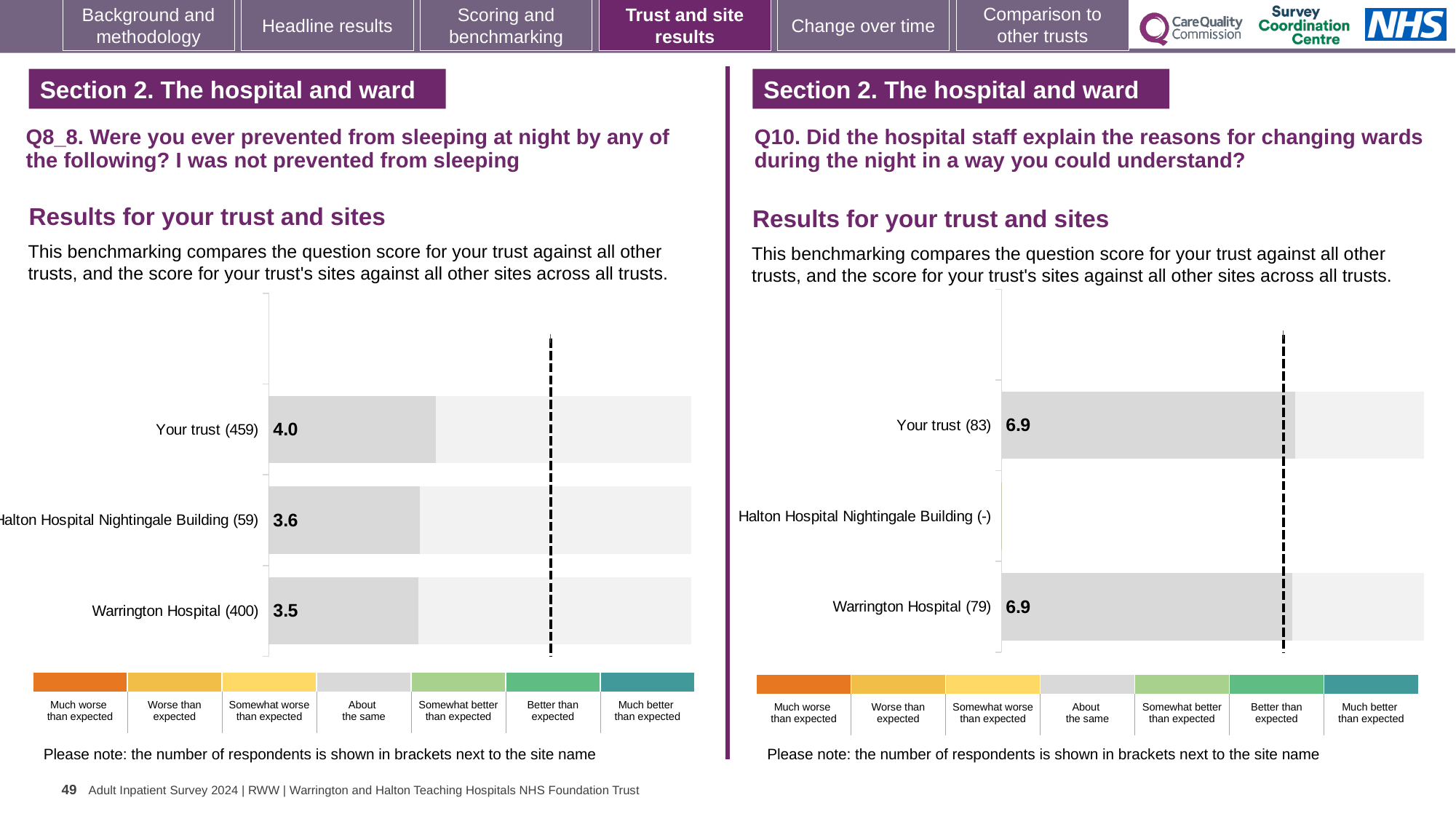
On the Q8_8 chart (left), what is the score for Halton Hospital Nightingale Building? 3.6 On the Q8_8 chart (left), what is the score for Your trust? 4.0 On the Q8_8 chart (left), which has the larger score: Halton Hospital Nightingale Building or Warrington Hospital? Halton Hospital Nightingale Building What kind of chart is used on the Q10 chart (right)? Bar chart On the Q8_8 chart (left), which site or trust has the lowest score? Warrington Hospital On the Q8_8 chart (left), what is the score for Warrington Hospital? 3.5 How many sites or trusts are listed on the Q8_8 chart (left)? 3 On the Q10 chart (right), what is the score for Warrington Hospital? 6.9 On the Q10 chart (right), how many respondents are shown in brackets for Your trust? 83 On the Q8_8 chart (left), which site or trust has the highest score? Your trust On the Q10 chart (right), what is the score for Your trust? 6.9 On the Q8_8 chart (left), what is the difference between the score for Your trust and the score for Warrington Hospital? 0.5